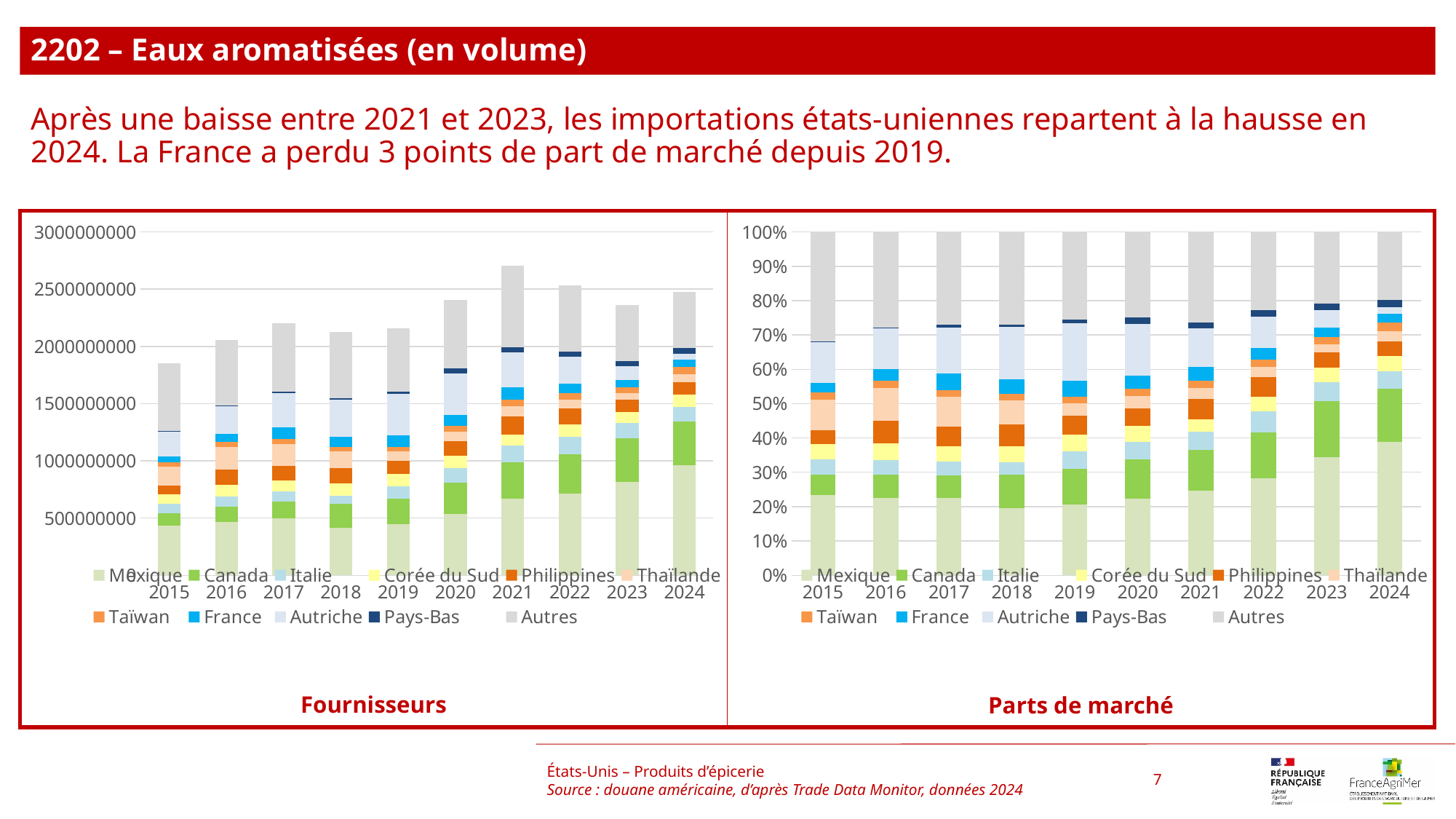
How many years are shown on the x axis of the 'Parts de marché' chart? 10 In the 'Fournisseurs' chart, which year has the highest total bar? 2021 What is the title of the chart on the right side of the slide? Parts de marché In the 'Fournisseurs' chart, which year has the lowest total bar? 2015 In the 'Fournisseurs' chart, is the total bar for 2021 greater or less than 2500000000? greater In the 'Parts de marché' chart, is the Autres share in 2024 greater or less than 30%? less What kind of chart is the 'Fournisseurs' chart on the left? stacked bar chart In the 'Fournisseurs' chart, is the total bar for 2015 greater or less than 2000000000? less In the 'Parts de marché' chart, does the Mexique share in 2024 appear larger or smaller than in 2015? larger In the 'Fournisseurs' chart, which total bar is larger, 2021 or 2023? 2021 How many series does the legend of the 'Fournisseurs' chart list? 11